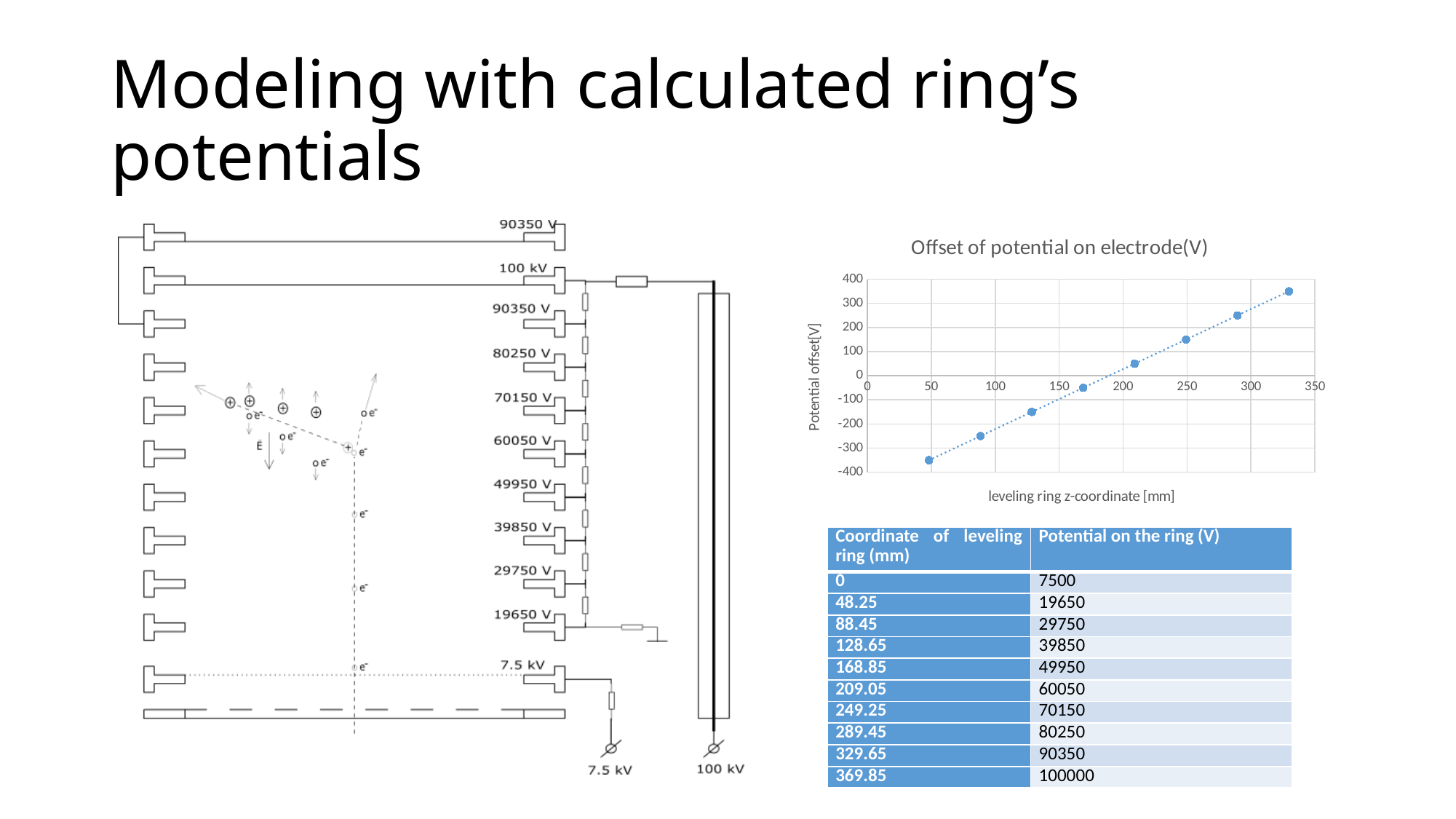
In the 'Offset of potential on electrode(V)' chart, is the value for the rightmost point (near z = 330 mm) greater or less than 300? greater In the 'Offset of potential on electrode(V)' chart, do the values rise or fall as the leveling ring z-coordinate increases? rise What is the x-axis title of the 'Offset of potential on electrode(V)' chart? leveling ring z-coordinate [mm] What kind of chart is 'Offset of potential on electrode(V)'? scatter chart In the 'Offset of potential on electrode(V)' chart, is the value for the point near z = 210 mm greater or less than 0? greater In the 'Offset of potential on electrode(V)' chart, is the value for the point near z = 170 mm greater or less than 0? less In the 'Offset of potential on electrode(V)' chart, which point has the lowest potential offset: the one near z = 50 mm or the one near z = 330 mm? the one near z = 50 mm What is the y-axis title of the 'Offset of potential on electrode(V)' chart? Potential offset[V] How many data points are plotted in the 'Offset of potential on electrode(V)' chart? 8